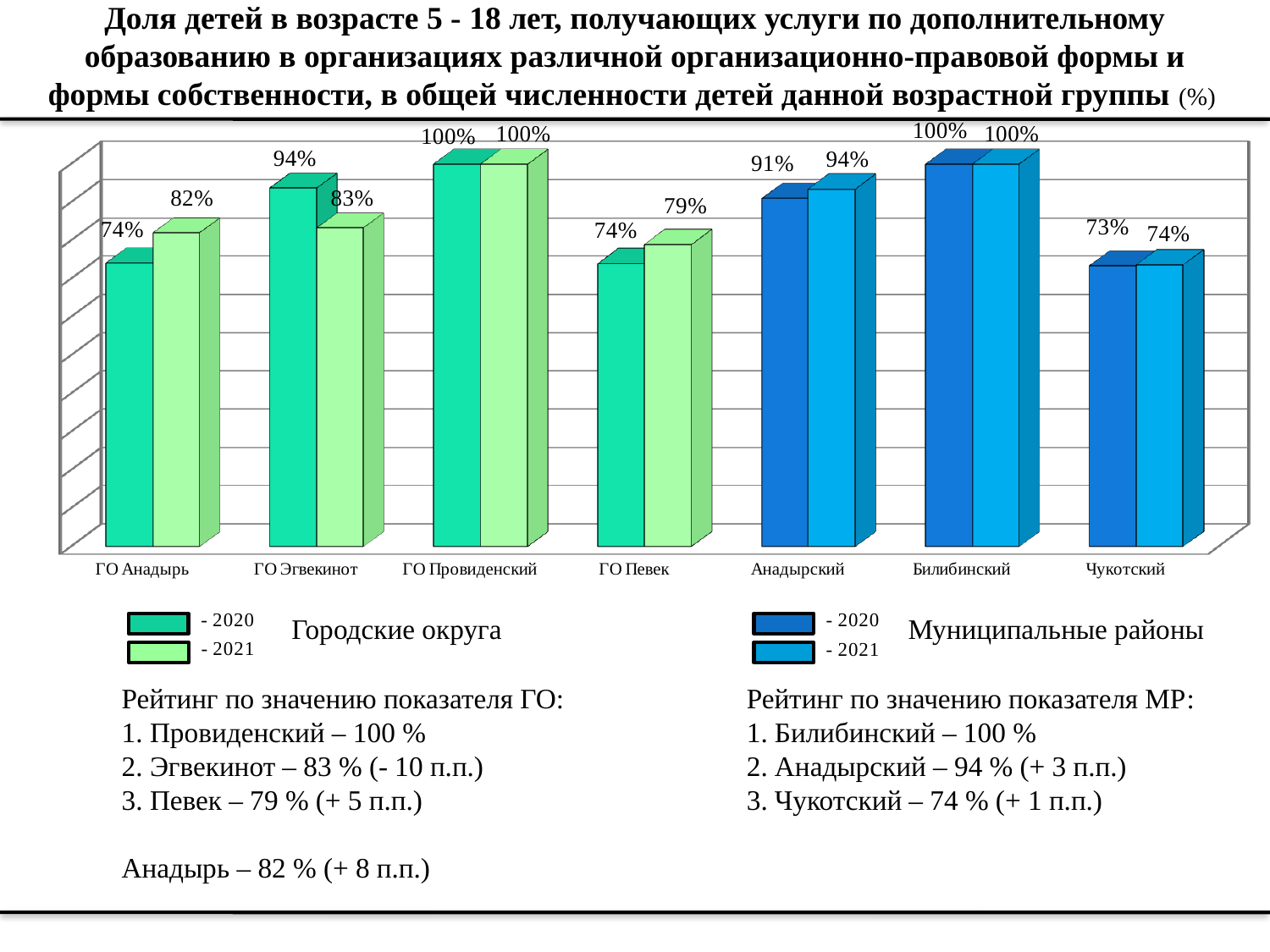
Which category has the lowest 2021 value? Чукотский What is the difference between the 2021 and 2020 values for ГО Певек? 5 percentage points How many series does the legend list? 2 What is the difference between the 2020 and 2021 values for ГО Эгвекинот? 11 percentage points What is the 2021 value for ГО Анадырь? 82% Which category has the lowest 2020 value? Чукотский How many categories are shown on the x axis? 7 What kind of chart is shown on the slide? Bar chart Which is larger: the 2021 value for ГО Анадырь or the 2021 value for ГО Певек? ГО Анадырь What is the 2020 value for Чукотский? 73% What is the 2020 value for ГО Эгвекинот? 94% What is the 2021 value for Анадырский? 94%